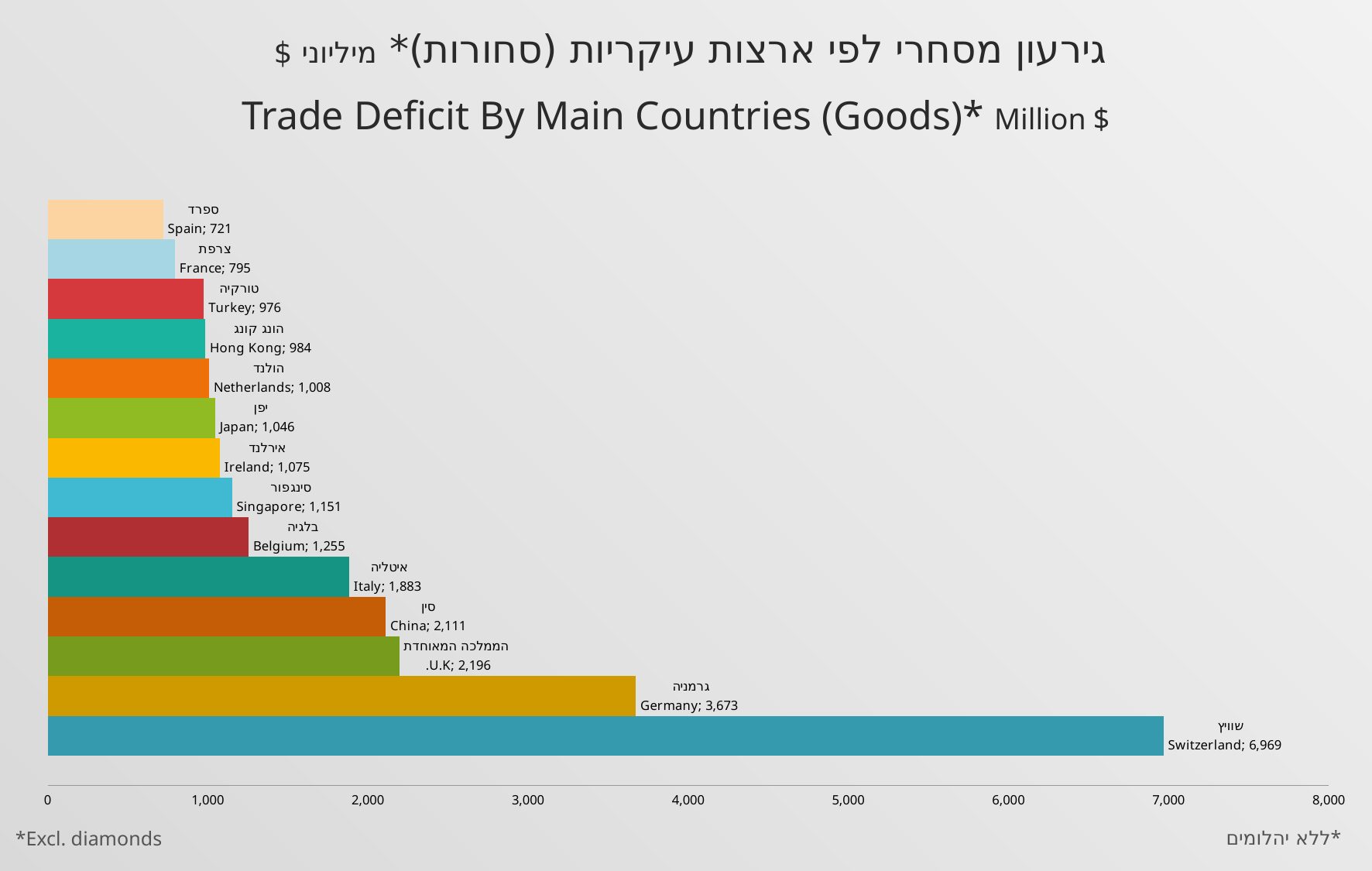
What kind of chart is shown on the slide? bar chart Is the value for Germany greater or less than 3,000? greater What is the trade deficit value for Netherlands? 1,008 What is the English title of the chart? Trade Deficit By Main Countries (Goods)* Million $ Which has a larger trade deficit, Italy or Belgium? Italy Which country has the lowest trade deficit on the chart? Spain What is the trade deficit value for Switzerland? 6,969 What is the difference between the trade deficit values for Switzerland and Germany? 3,296 Which country has the highest trade deficit on the chart? Switzerland What is the trade deficit value for Germany? 3,673 What is the difference between the trade deficit values for U.K. and China? 85 How many countries are shown on the chart? 14